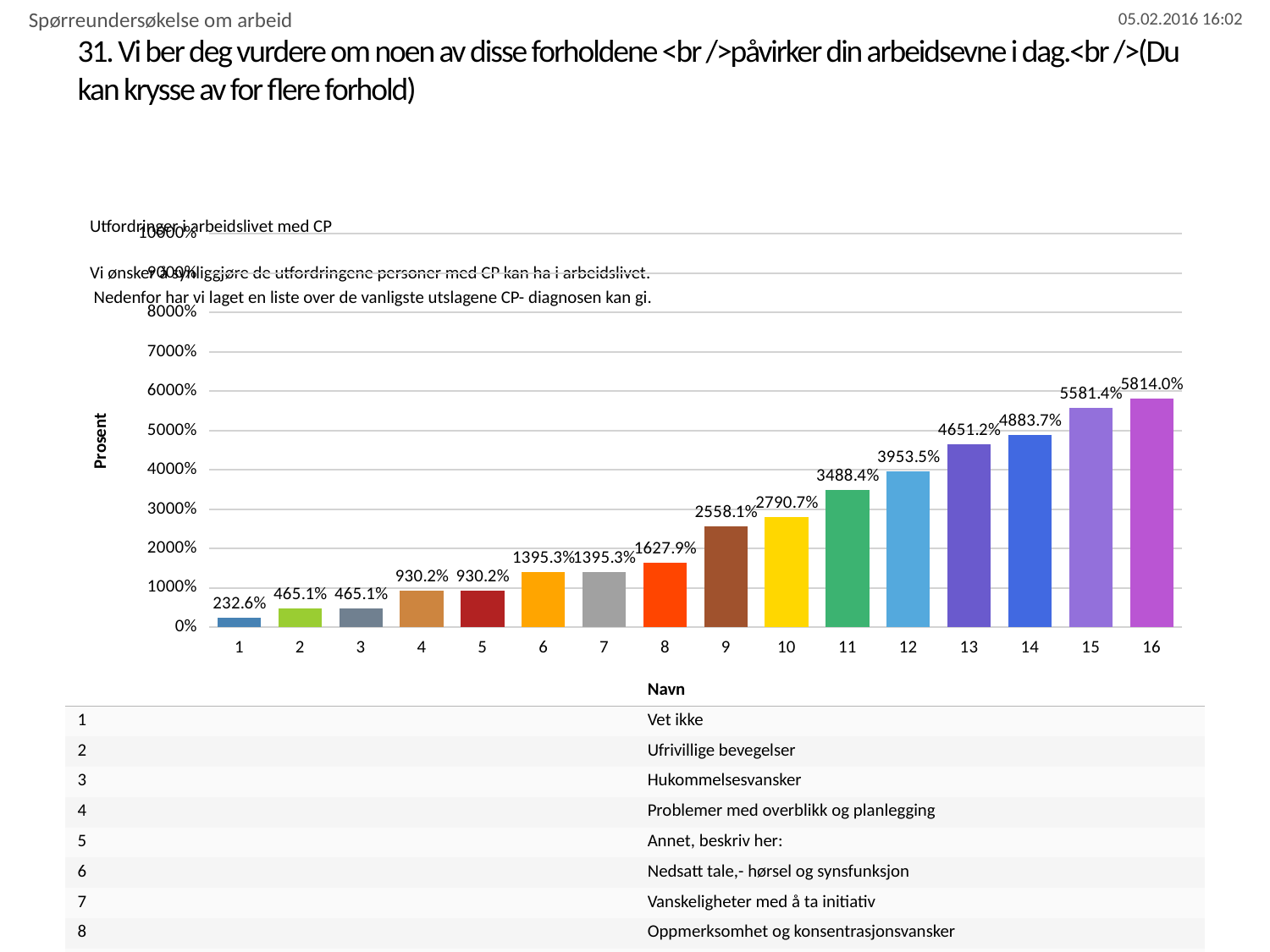
What is the difference between the values for category 16 and category 15? 232.6% How many bars (categories) does the chart show? 16 Which category has the lowest value? 1 What is the value for category 1? 232.6% What is the value for category 13? 4651.2% Do the values rise or fall from category 1 to category 16 along the x axis? rise What is the value for category 9? 2558.1% What kind of chart is shown on the slide? bar chart What is the label on the vertical axis of the chart? Prosent Which is larger, the value for category 10 or the value for category 8? category 10 What is the difference between the values for category 12 and category 11? 465.1% Which category has the highest value? 16